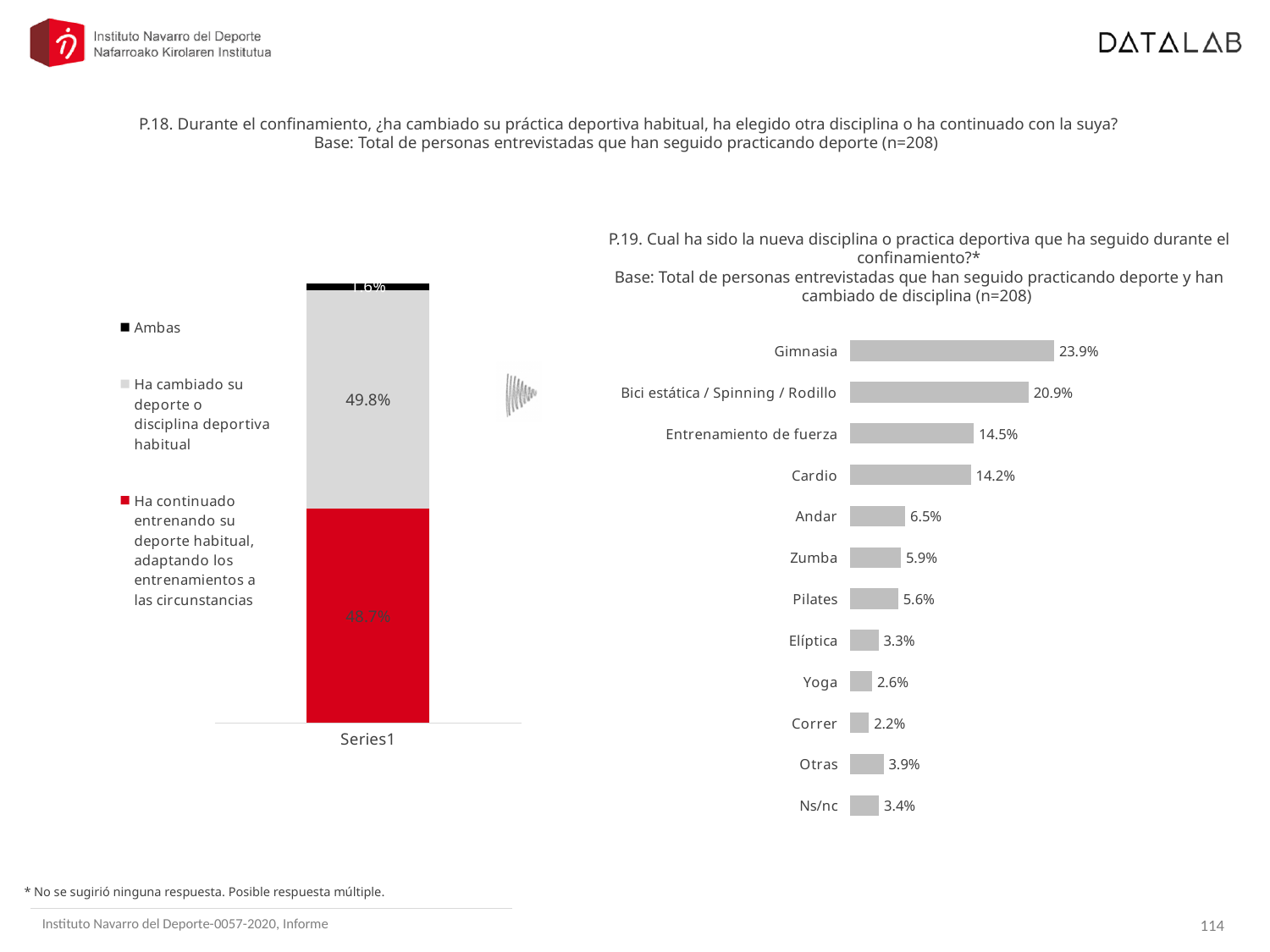
In the P.19 chart on the right, which category has the highest value? Gimnasia How many categories are shown in the P.19 chart on the right? 12 In the P.18 stacked bar chart on the left, what is the value for 'Ha continuado entrenando su deporte habitual, adaptando los entrenamientos a las circunstancias'? 48.7% In the P.19 chart on the right, which category has the lowest value? Correr In the P.19 chart on the right, which is larger, Entrenamiento de fuerza or Cardio? Entrenamiento de fuerza In the P.19 chart on the right, what is the difference between Gimnasia and Bici estática / Spinning / Rodillo? 3.0% In the P.19 chart on the right, what is the value for Zumba? 5.9% How many series does the legend of the P.18 stacked bar chart on the left list? 3 What kind of chart is the P.19 chart on the right? Bar chart In the P.19 chart on the right, what is the value for Bici estática / Spinning / Rodillo? 20.9% In the P.18 stacked bar chart on the left, what is the value for 'Ha cambiado su deporte o disciplina deportiva habitual'? 49.8% In the P.19 chart on the right, what is the value for Gimnasia? 23.9%